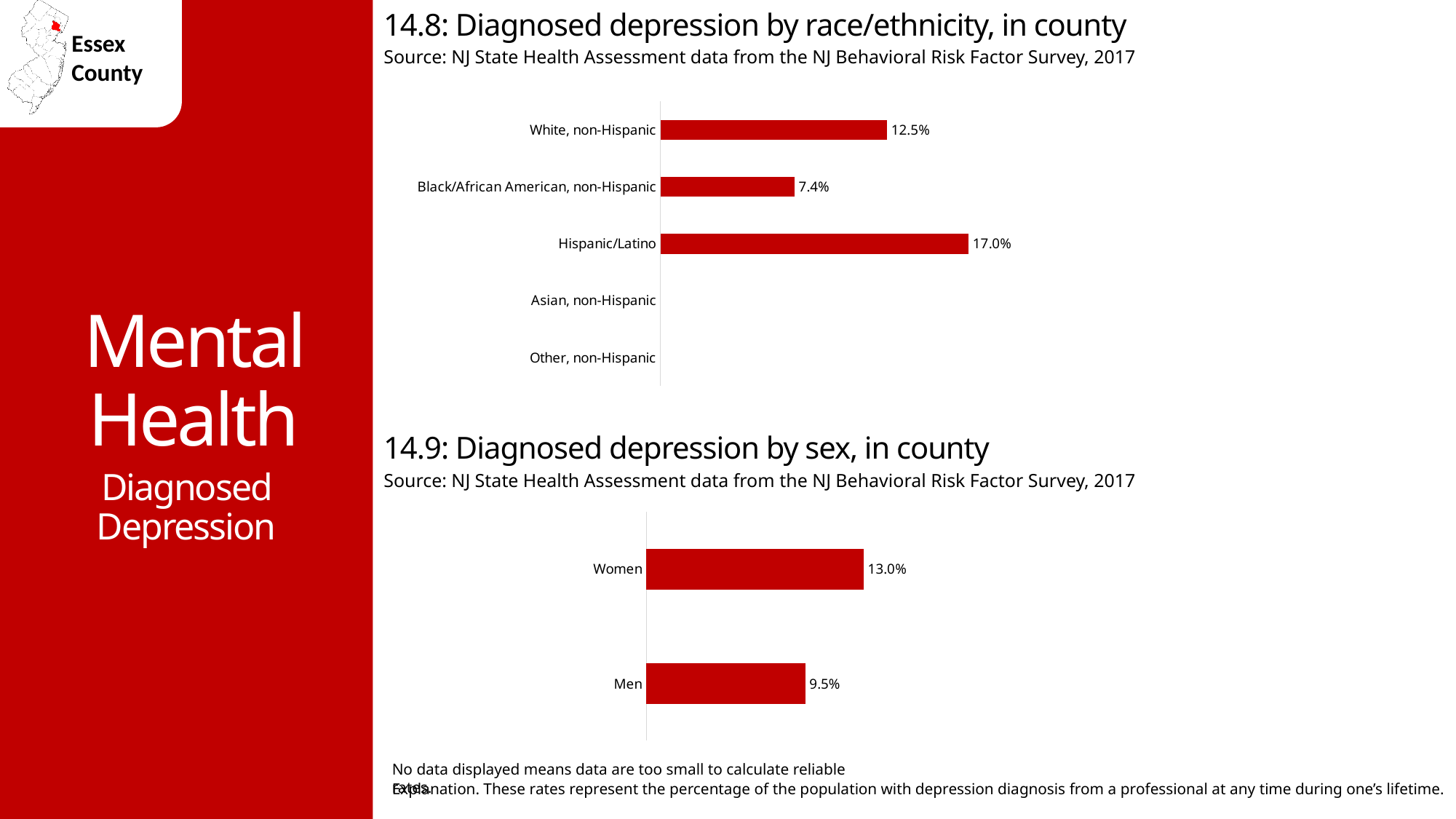
In the chart '14.8: Diagnosed depression by race/ethnicity, in county', which categories have no bar displayed? Asian, non-Hispanic and Other, non-Hispanic In the chart '14.9: Diagnosed depression by sex, in county', what is the value for Men? 9.5% In the chart '14.8: Diagnosed depression by race/ethnicity, in county', what is the difference between the values for Hispanic/Latino and White, non-Hispanic? 4.5% In the chart '14.8: Diagnosed depression by race/ethnicity, in county', which group with a displayed value has the lowest value? Black/African American, non-Hispanic In the chart '14.9: Diagnosed depression by sex, in county', what is the value for Women? 13.0% In the chart '14.9: Diagnosed depression by sex, in county', what is the difference between the values for Women and Men? 3.5% In the chart '14.8: Diagnosed depression by race/ethnicity, in county', what is the value for Black/African American, non-Hispanic? 7.4% In the chart '14.8: Diagnosed depression by race/ethnicity, in county', which race/ethnicity group has the highest value? Hispanic/Latino What kind of chart is '14.9: Diagnosed depression by sex, in county'? Bar chart In the chart '14.8: Diagnosed depression by race/ethnicity, in county', how many race/ethnicity categories are listed on the axis? 5 In the chart '14.8: Diagnosed depression by race/ethnicity, in county', what is the value for Hispanic/Latino? 17.0% In the chart '14.9: Diagnosed depression by sex, in county', which is larger, the value for Women or the value for Men? Women